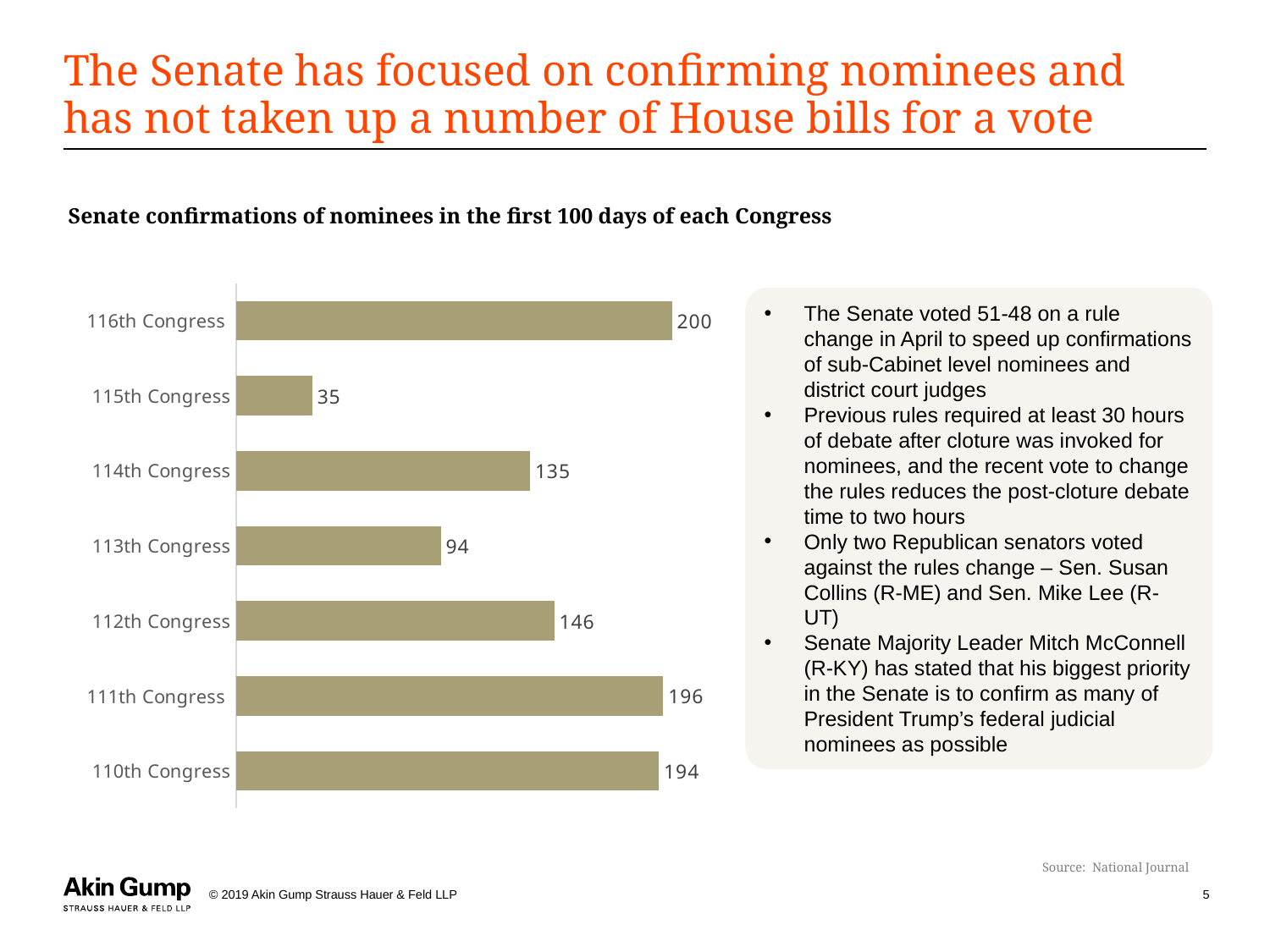
Which Congress has the lowest number of confirmations in the chart? 115th Congress What is the difference between the confirmations for the 116th Congress and the 115th Congress? 165 What is the title of the chart? Senate confirmations of nominees in the first 100 days of each Congress Which had more confirmations, the 114th Congress or the 113th Congress? 114th Congress What type of chart is used on this slide? Bar chart Which Congress has the highest number of confirmations in the chart? 116th Congress What is the value shown for the 113th Congress? 94 How many Congresses are shown in the chart? 7 What is the difference between the confirmations for the 112th Congress and the 114th Congress? 11 How many nominees were confirmed in the first 100 days of the 116th Congress? 200 What is the value shown for the 115th Congress? 35 Which had more confirmations, the 111th Congress or the 110th Congress? 111th Congress